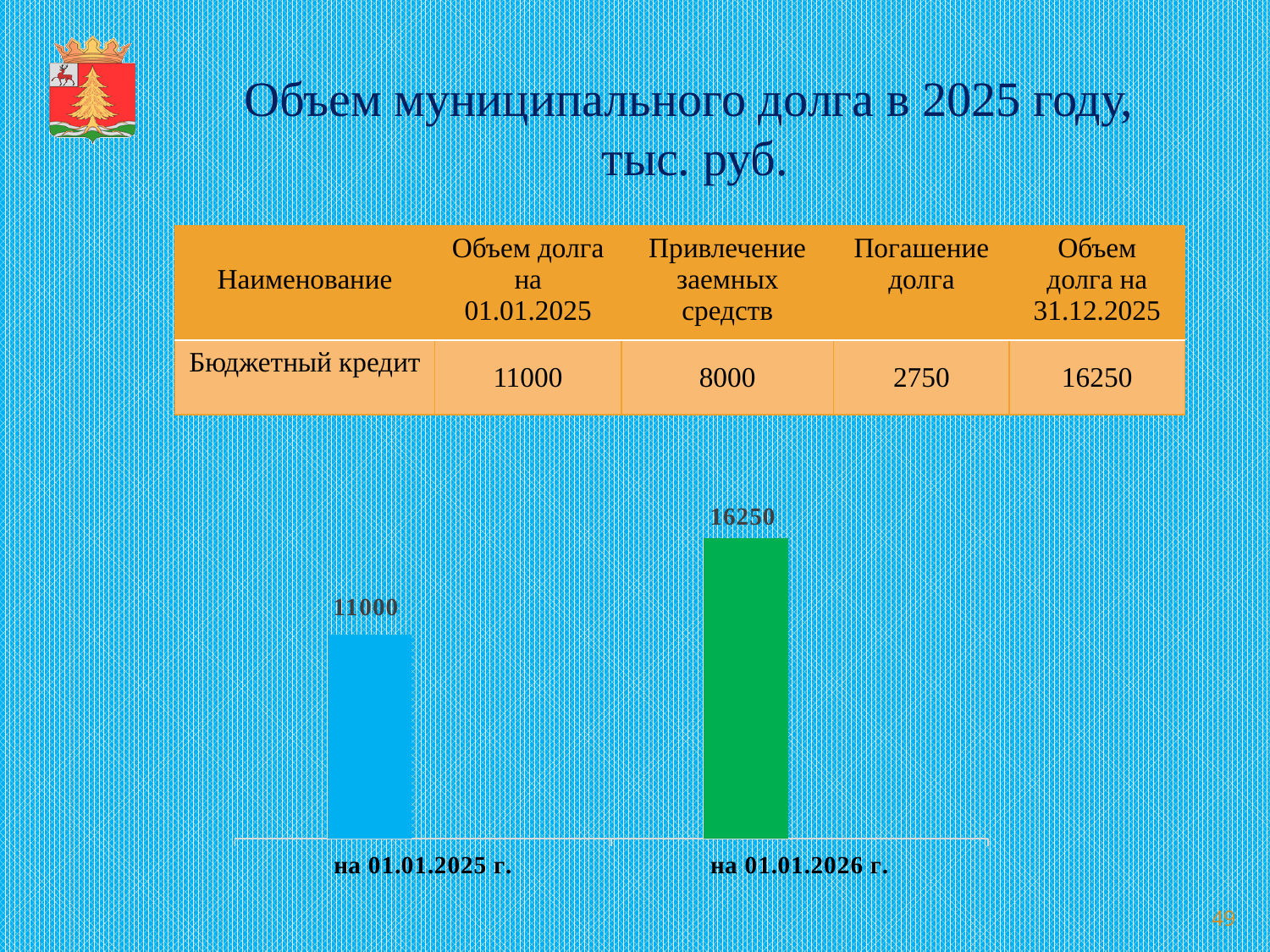
What colour is the bar for "на 01.01.2025 г."? blue What is the value of the bar labelled "на 01.01.2025 г."? 11000 How many bars are shown in the chart? 2 Which is larger: the value for "на 01.01.2025 г." or the value for "на 01.01.2026 г."? на 01.01.2026 г. What colour is the bar for "на 01.01.2026 г."? green Which category has the lowest bar? на 01.01.2025 г. Do the values rise or fall from "на 01.01.2025 г." to "на 01.01.2026 г."? rise Which category has the highest bar? на 01.01.2026 г. What is the value of the bar labelled "на 01.01.2026 г."? 16250 What kind of chart is shown on the slide? bar chart What is the difference between the values for "на 01.01.2026 г." and "на 01.01.2025 г."? 5250